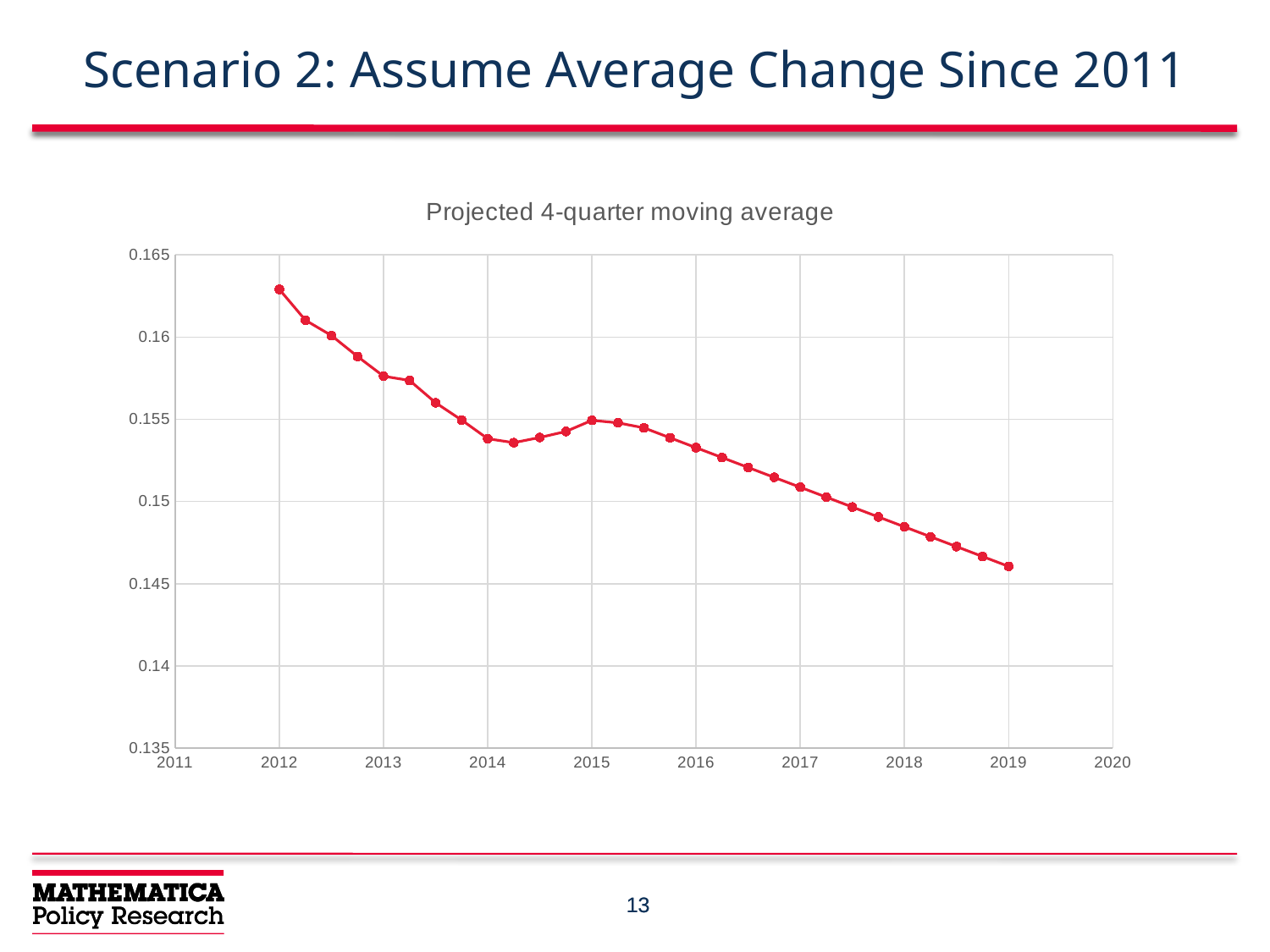
What is the lowest value shown on the vertical axis? 0.135 At which year does the line reach its highest value? 2012 Is the value at 2018 greater or less than 0.15? less What kind of chart is shown on the slide? line chart Is the value at 2014 greater or less than 0.155? less Is the value at 2019 greater or less than 0.15? less Which is larger, the value at 2013 or the value at 2016? 2013 At which year does the line reach its lowest value? 2019 Do the values generally rise or fall from 2012 to 2019? fall What is the title of the chart? Projected 4-quarter moving average